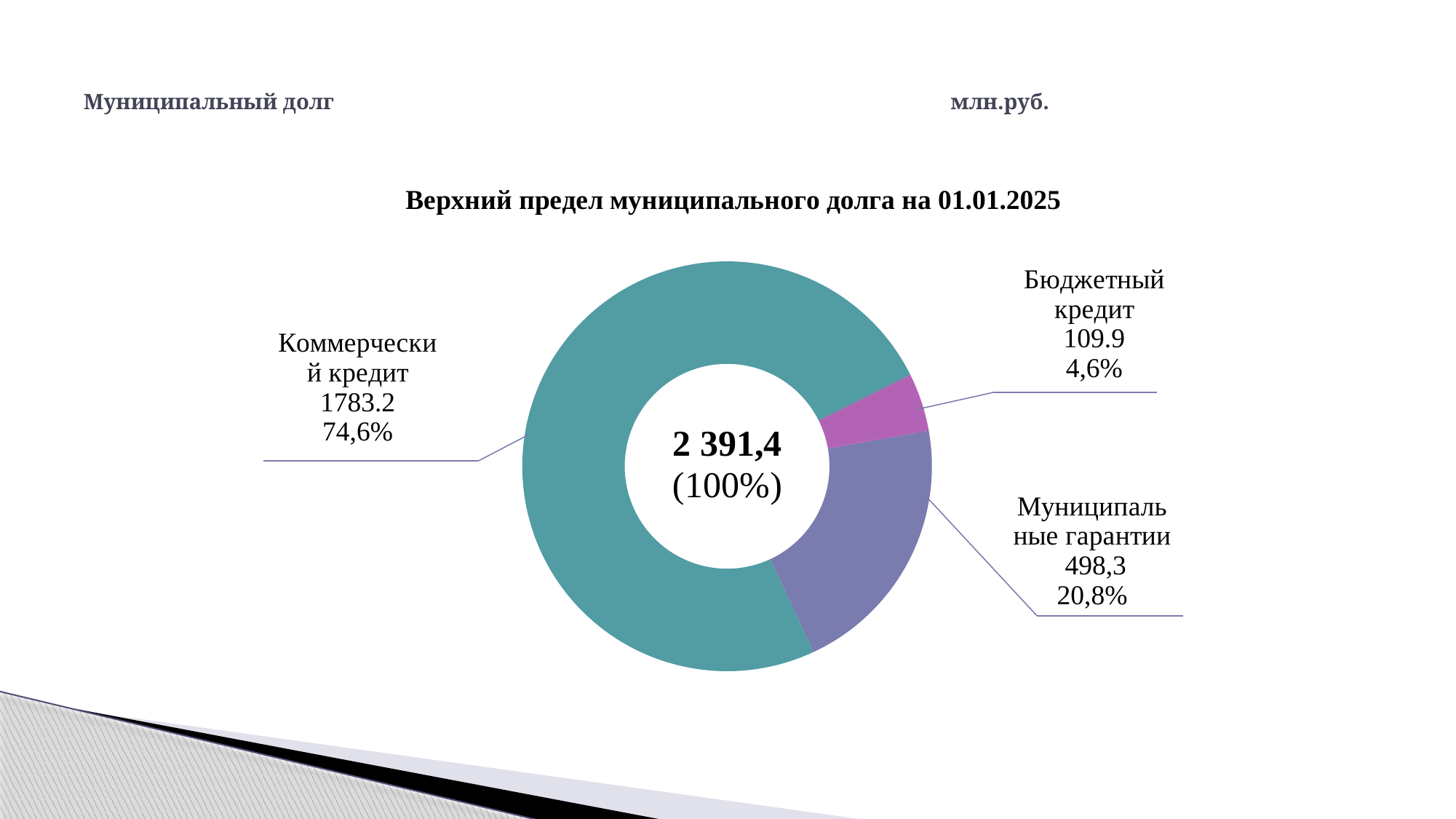
What is the total value shown in the centre of the chart? 2 391,4 What share of the total does Коммерческий кредит represent? 74,6% Which category has the smallest share? Бюджетный кредит Which is larger, Муниципальные гарантии or Бюджетный кредит? Муниципальные гарантии What is the value for Коммерческий кредит? 1783.2 What type of chart is shown on the slide? Pie (donut) chart Which category has the largest share? Коммерческий кредит What is the value for Бюджетный кредит? 109.9 What is the value for Муниципальные гарантии? 498,3 How many categories does the chart show? 3 What is the title of the chart? Верхний предел муниципального долга на 01.01.2025 What share of the total does Муниципальные гарантии represent? 20,8%